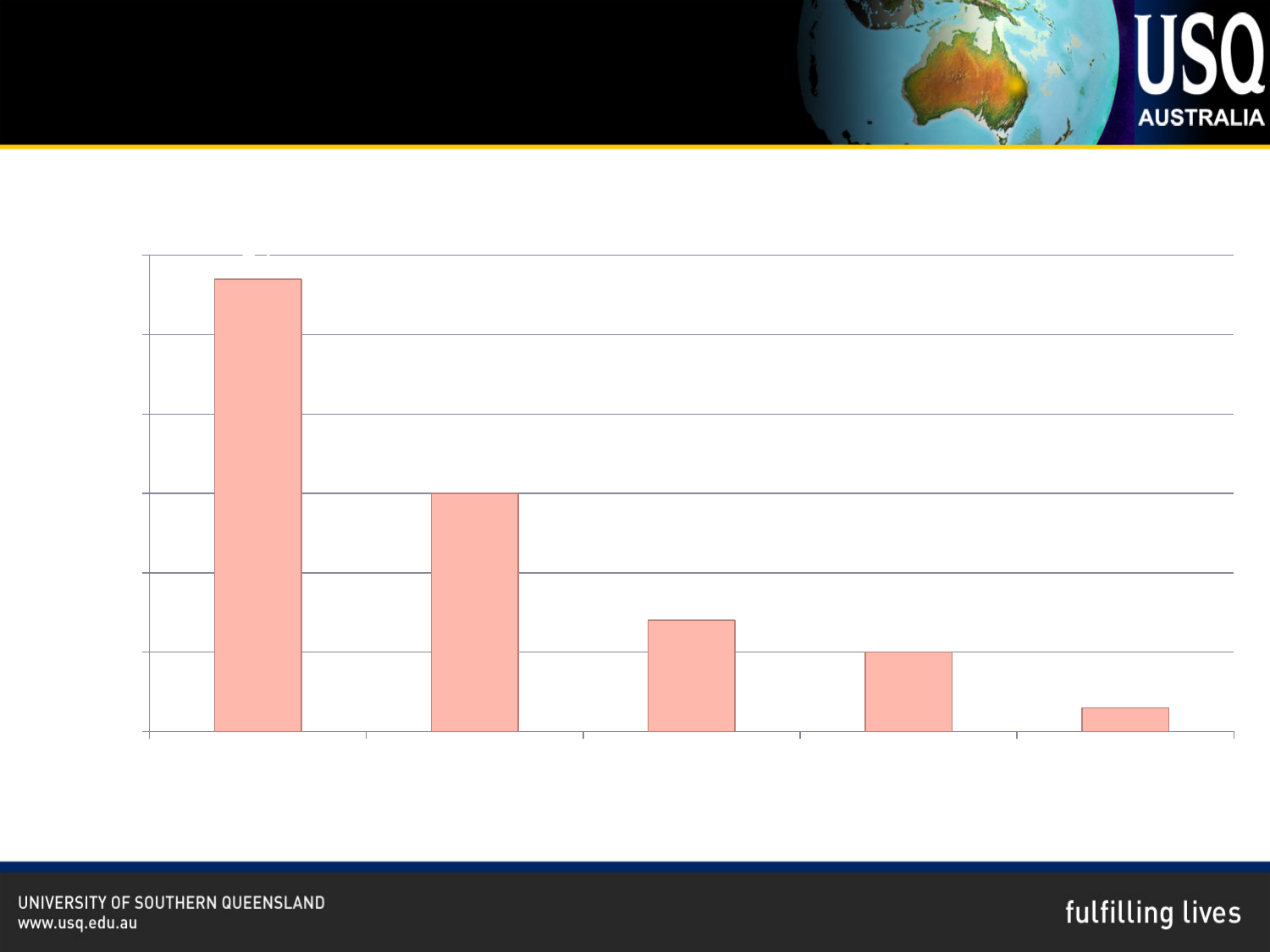
Which bar is the shortest in the chart? the rightmost (fifth) bar Which is taller, the fourth bar from the left or the fifth bar from the left? the fourth bar What colour are the bars in the chart? light pink (salmon) What kind of chart is shown on the slide? bar chart How many bars are plotted in the chart? 5 Which is taller, the second bar from the left or the third bar from the left? the second bar Do the bar values rise or fall from left to right across the chart? fall Are the bars in the chart vertical or horizontal? vertical Which bar is the tallest in the chart? the leftmost (first) bar